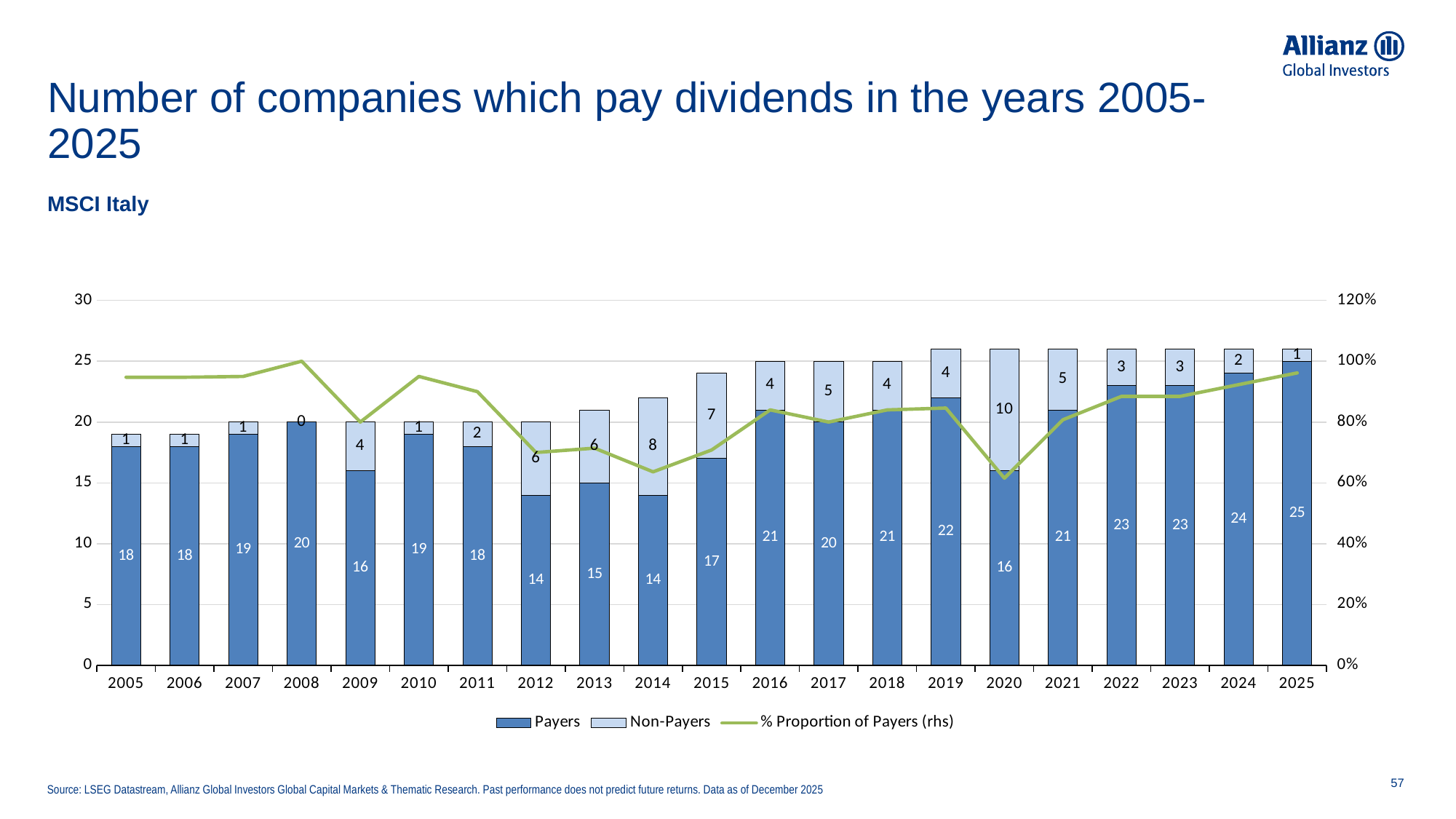
Which year has the highest number of Payers? 2025 Is the % Proportion of Payers for 2020 greater or less than 80%? less What is the total height of the stacked bar for 2020 (Payers plus Non-Payers)? 26 How many years are shown on the x axis? 21 How many Payers are shown for 2012? 14 How many series does the legend list? 3 Which year has the highest number of Non-Payers? 2020 Which year has the lowest number of Non-Payers? 2008 Which is larger, the Payers value for 2016 or for 2017? 2016 What is the Non-Payers value for 2020? 10 What is the difference between the Payers values for 2025 and 2020? 9 How many Payers are shown for 2025? 25